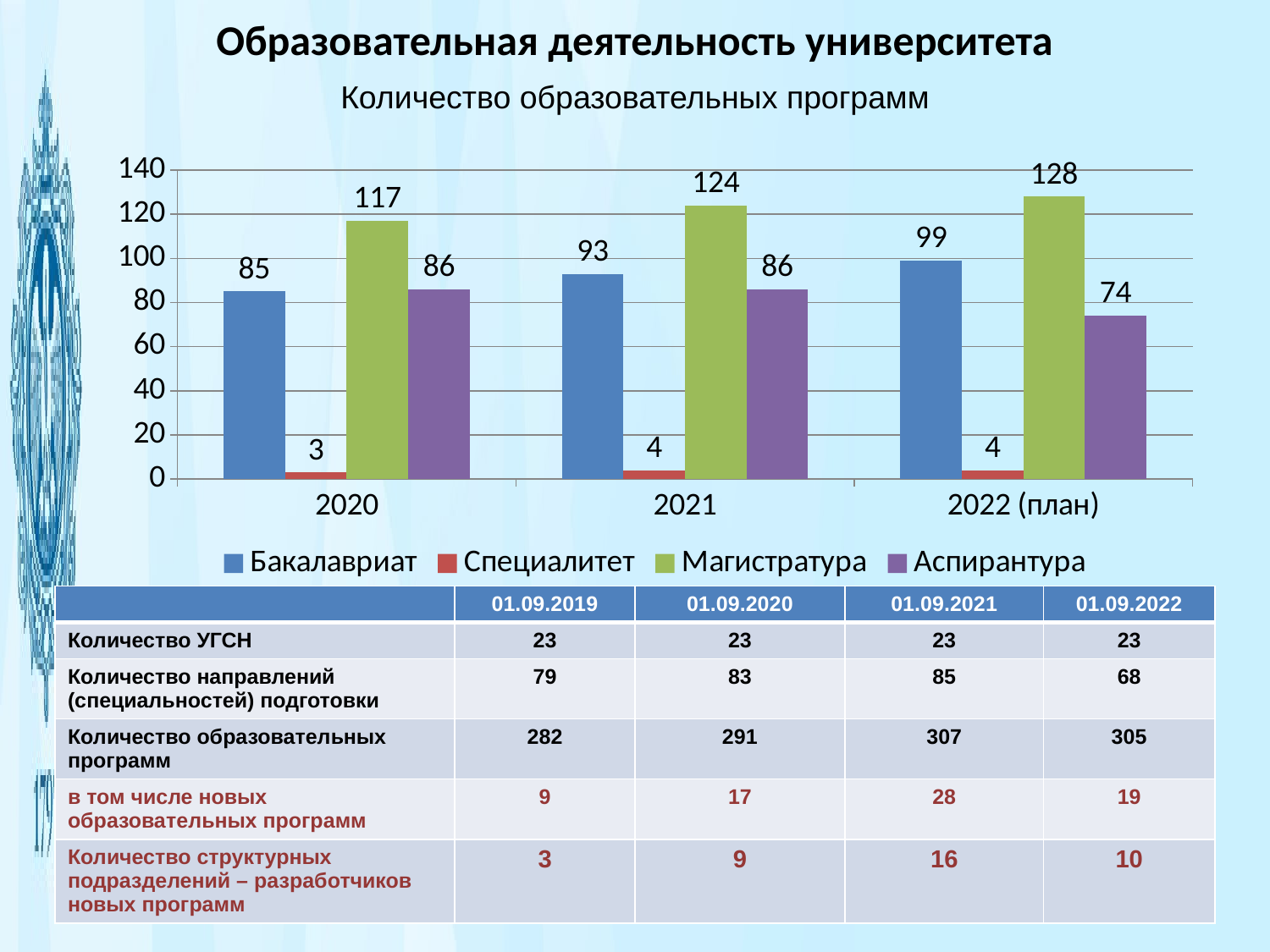
Which series has the lowest value in 2020? Специалитет Which series has the highest value in 2022 (план)? Магистратура Which is larger: Аспирантура in 2021 or Аспирантура in 2022 (план)? Аспирантура in 2021 What is the value for Бакалавриат in 2020? 85 Do the values for Бакалавриат rise or fall from 2020 to 2022 (план)? rise What is the difference between Магистратура and Бакалавриат in 2022 (план)? 29 What kind of chart is shown? bar chart What is the value for Аспирантура in 2022 (план)? 74 How many categories are shown on the x axis? 3 Is the value for Бакалавриат in 2022 (план) greater or less than 80? greater How many series does the legend list? 4 What is the value for Магистратура in 2021? 124